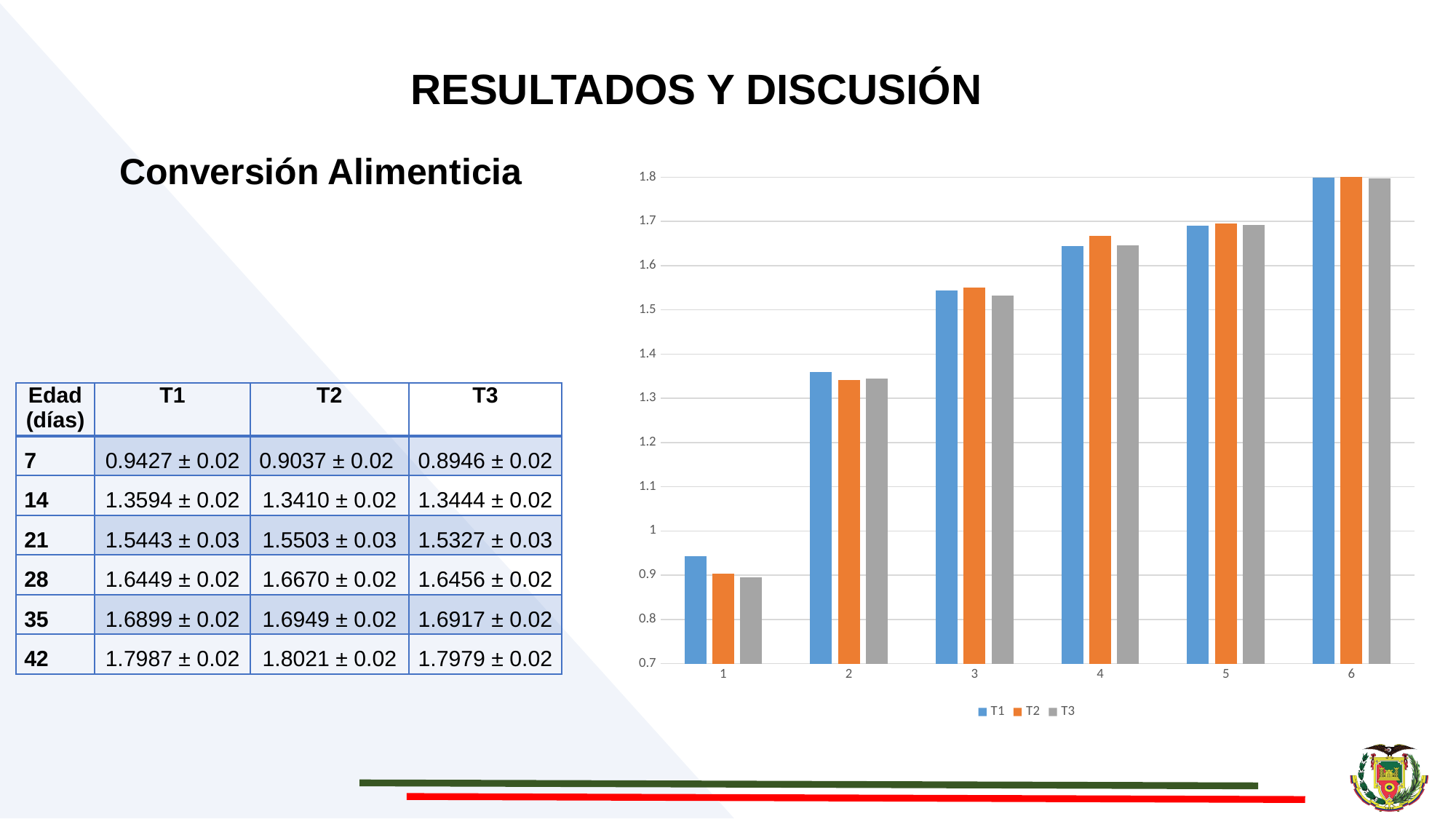
Is the value for T2 at category 4 greater or less than 1.6? greater Which category on the x axis has the highest bars? 6 Is the value for T3 at category 6 greater or less than 1.7? greater At category 1, which is larger, T1 or T2? T1 What kind of chart is shown on the slide? bar chart Do the values rise or fall from category 1 to category 6? rise Is the value for T1 at category 2 greater or less than 1.3? greater How many categories are shown on the x axis of the chart? 6 How many series does the chart legend list? 3 At category 4, which is larger, T1 or T2? T2 Which category on the x axis has the lowest bars? 1